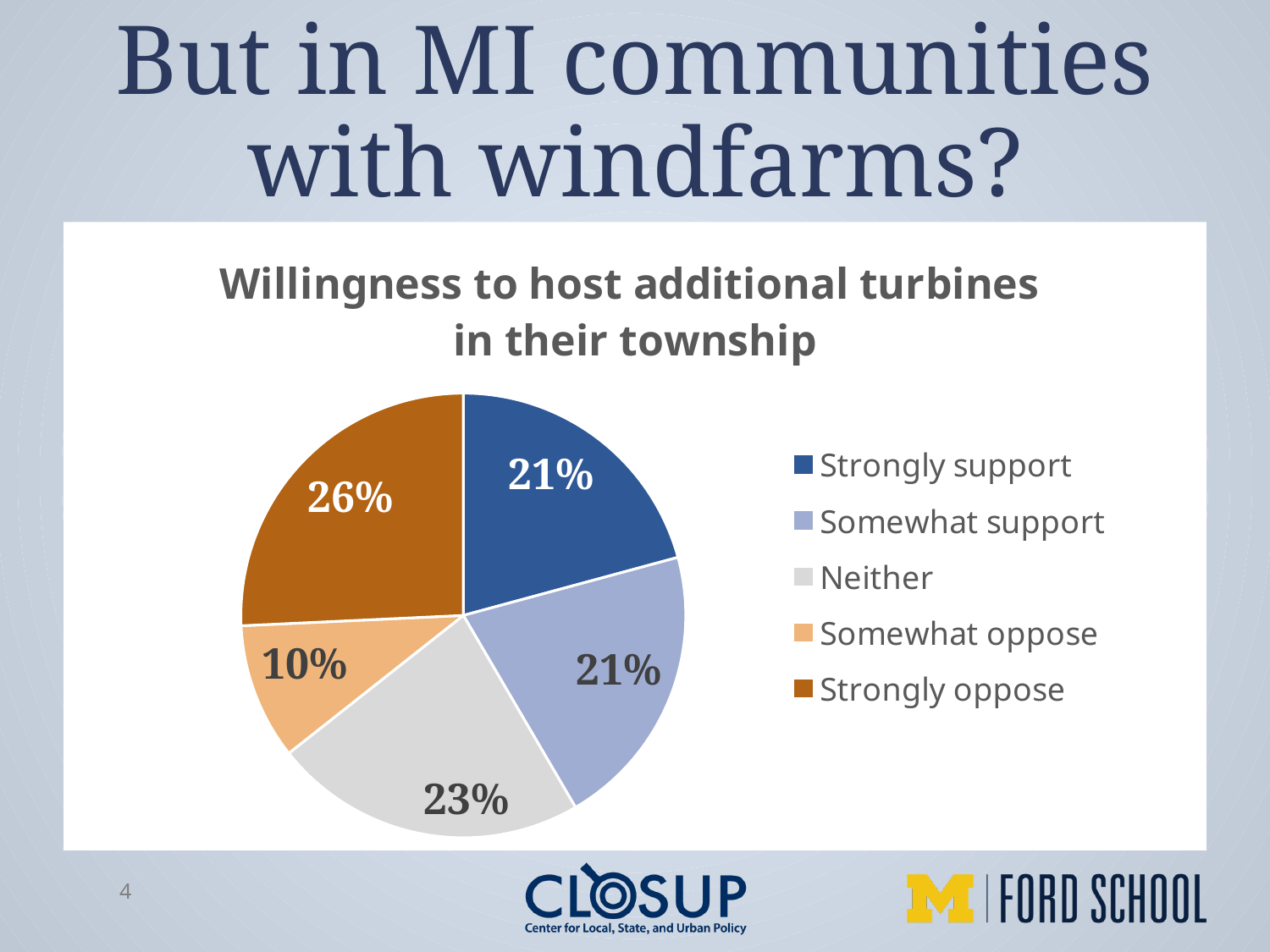
What percentage of respondents answered 'Neither'? 23% What percentage of respondents somewhat oppose hosting additional turbines? 10% What is the title of the chart? Willingness to host additional turbines in their township What percentage of respondents strongly oppose hosting additional turbines? 26% Which response category has the largest share of the pie? Strongly oppose What type of chart is shown on the slide? Pie chart What colour is the 'Strongly oppose' slice in the pie chart? Brown What is the difference in percentage points between 'Strongly oppose' and 'Somewhat oppose'? 16 Which response category has the smallest share of the pie? Somewhat oppose Which is larger: the share for 'Neither' or the share for 'Somewhat support'? Neither How many response categories are shown in the pie chart? 5 What percentage of respondents strongly support hosting additional turbines in their township? 21%